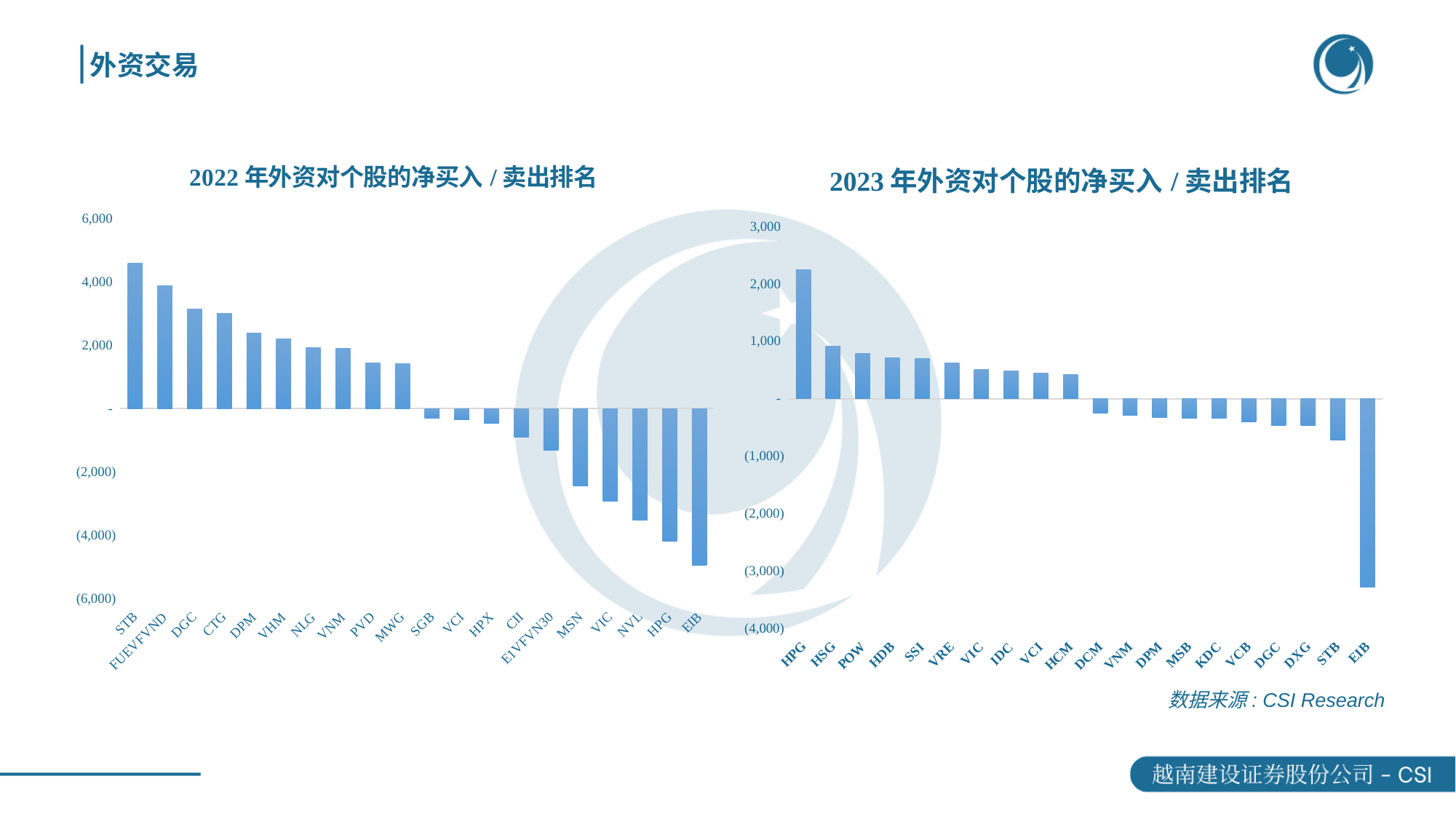
In the 2022 年外资对个股的净买入 / 卖出排名 chart, which stock has the lowest value? EIB How many stock categories are shown on the x axis of the 2023 年外资对个股的净买入 / 卖出排名 chart? 20 In the 2023 年外资对个股的净买入 / 卖出排名 chart, do the values rise or fall from left to right along the x axis? fall What kind of chart is the 2022 年外资对个股的净买入 / 卖出排名 chart? bar chart In the 2023 年外资对个股的净买入 / 卖出排名 chart, which stock has the highest value? HPG In the 2022 年外资对个股的净买入 / 卖出排名 chart, which is larger, the value for STB or the value for FUEVFVND? STB In the 2022 年外资对个股的净买入 / 卖出排名 chart, which stock has the highest value? STB How many stock categories are shown on the x axis of the 2022 年外资对个股的净买入 / 卖出排名 chart? 20 In the 2022 年外资对个股的净买入 / 卖出排名 chart, is the value for STB greater or less than 4,000? greater In the 2023 年外资对个股的净买入 / 卖出排名 chart, is the value for HPG greater or less than 2,000? greater In the 2023 年外资对个股的净买入 / 卖出排名 chart, which stock has the lowest value? EIB In the 2023 年外资对个股的净买入 / 卖出排名 chart, is the value for EIB greater or less than (3,000)? less